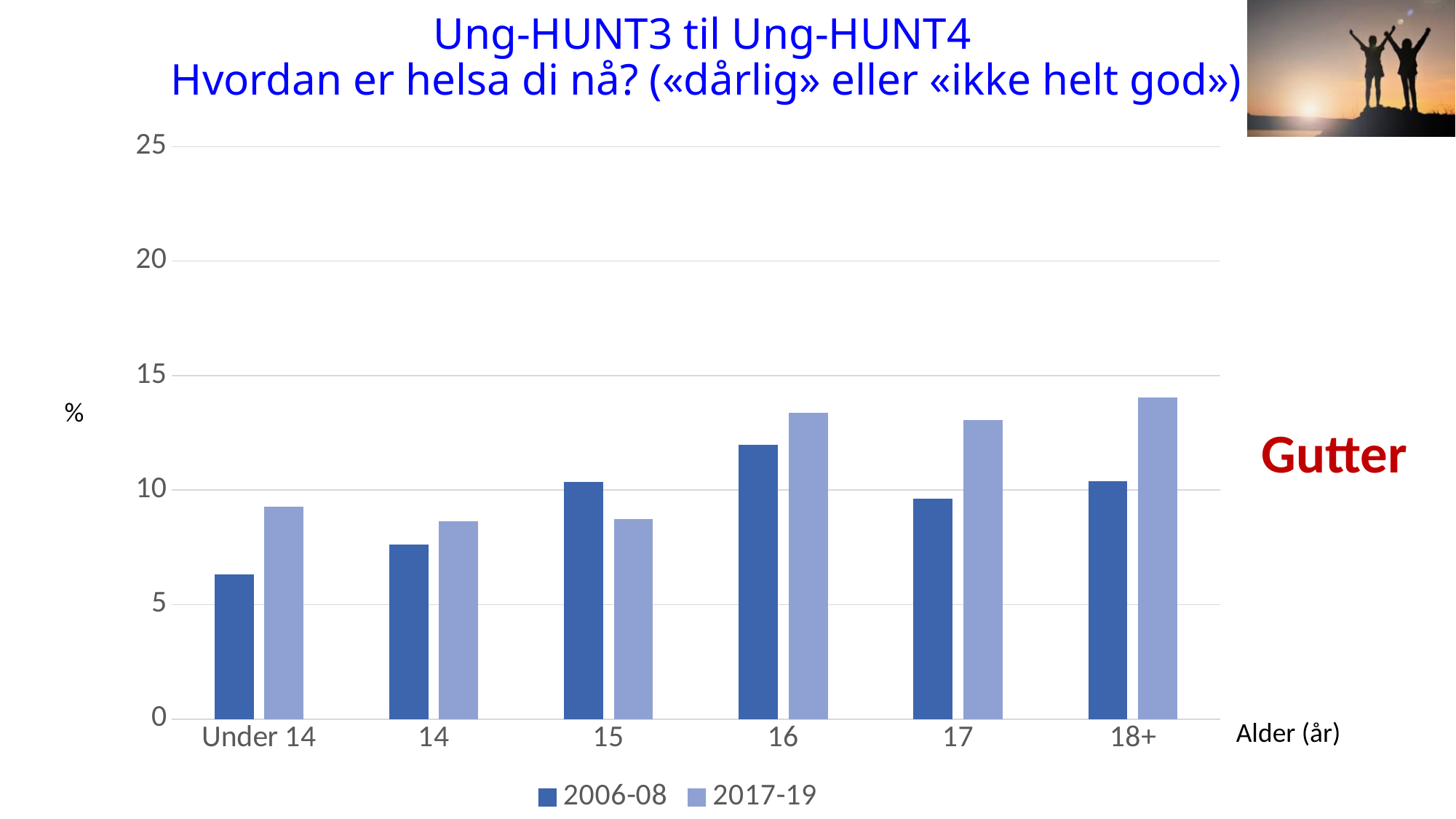
Is the 2017-19 value for 18+ greater or less than 15? less Which age category has the highest value for the 2017-19 series? 18+ What are the two series named in the legend? 2006-08 and 2017-19 Which age category has the highest value for the 2006-08 series? 16 How many series does the legend list? 2 For age 17, which series has the larger value, 2006-08 or 2017-19? 2017-19 For age 15, which series has the larger value, 2006-08 or 2017-19? 2006-08 Is the 2017-19 value for 17 greater or less than 10? greater How many age categories are shown on the x axis? 6 Is the 2006-08 value for Under 14 greater or less than 10? less Which age category has the lowest value for the 2006-08 series? Under 14 What kind of chart is shown on the slide? bar chart